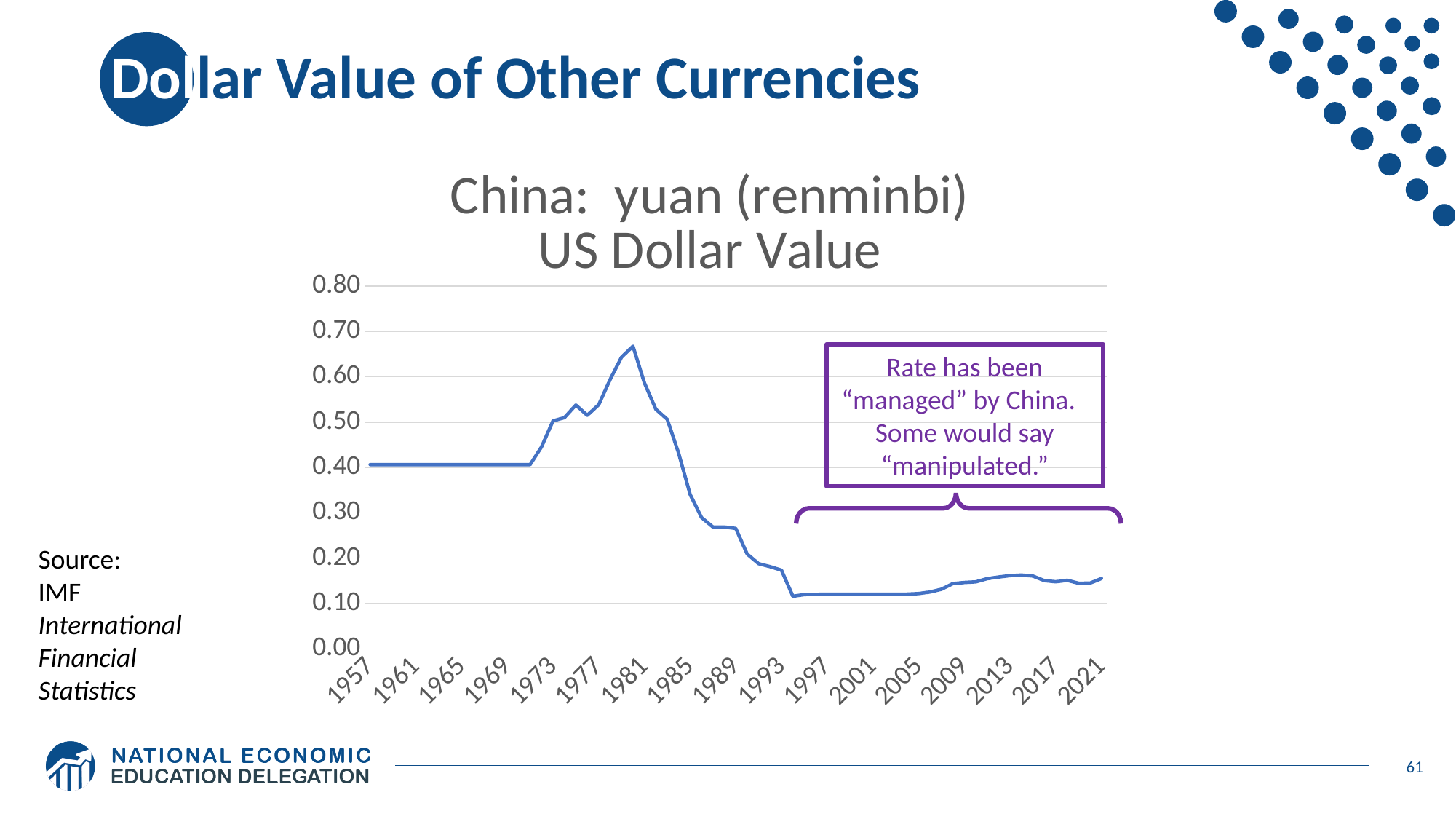
Is the value for 1977 greater or less than 0.40? greater Does the value rise or fall between 1981 and 1993? fall Does the value rise or fall between 1969 and 1977? rise Is the value for 1965 greater or less than 0.50? less Is the value for 1997 greater or less than 0.20? less What is the title of the chart? China: yuan (renminbi) US Dollar Value What source is cited for the chart data? IMF International Financial Statistics How many lines are plotted on the chart? 1 What kind of chart is shown on the slide? line chart